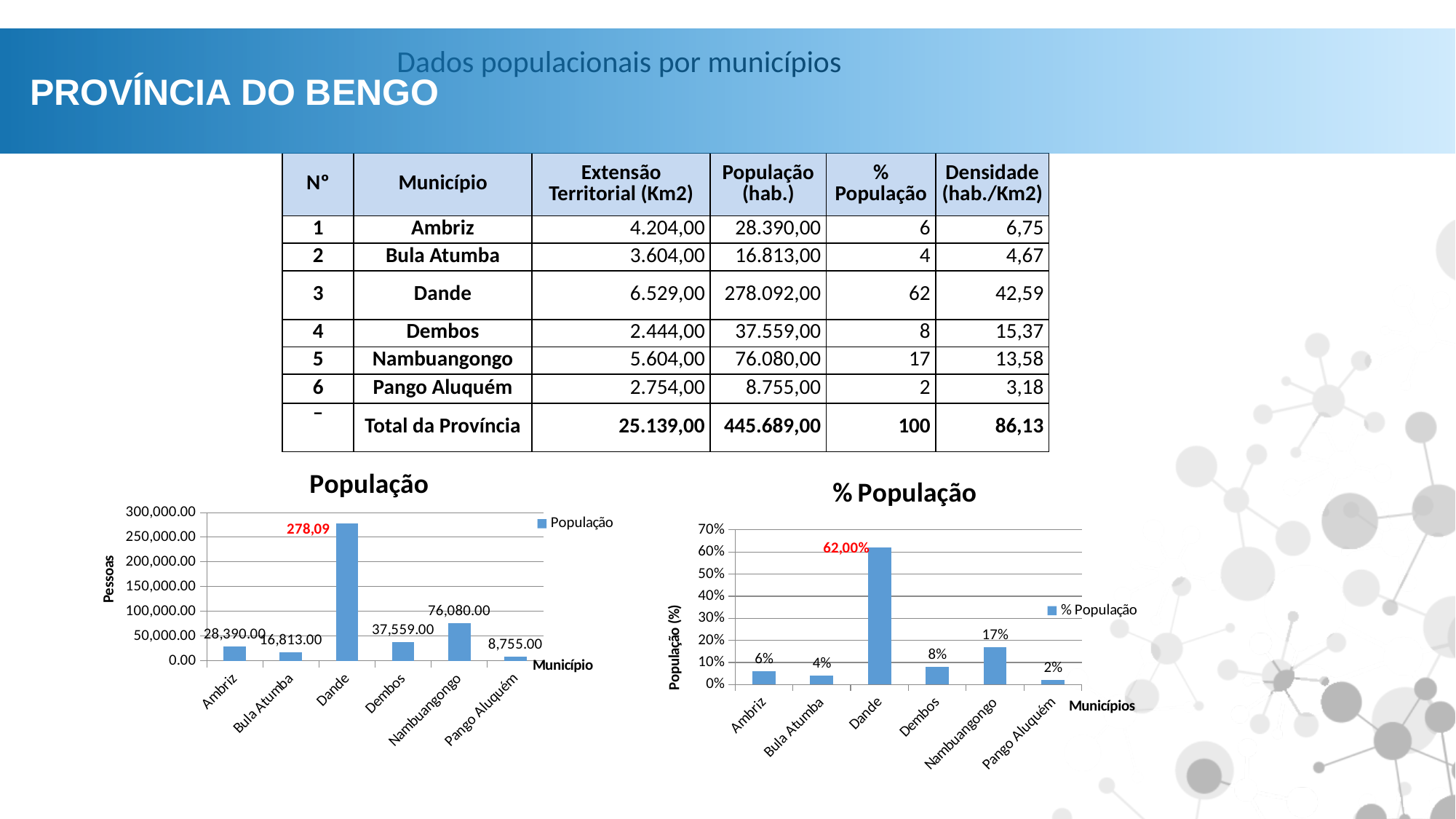
In the "População" chart, which município has the lowest population? Pango Aluquém In the "% População" chart, what is the value for Dande? 62,00% In the "População" chart, what is the value for Nambuangongo? 76,080.00 In the "População" chart, what is the value for Ambriz? 28,390.00 In the "% População" chart, what is the value for Nambuangongo? 17% In the "População" chart, how many municípios are shown on the x axis? 6 In the "População" chart, what is the difference between the values for Dembos and Bula Atumba? 20,746.00 In the "População" chart, which município has the highest population? Dande What kind of chart is the "% População" chart? Bar chart How many series does the legend of the "% População" chart list? 1 In the "% População" chart, is the value for Dande greater or less than 50%? greater In the "% População" chart, which is larger, the value for Ambriz or the value for Dembos? Dembos